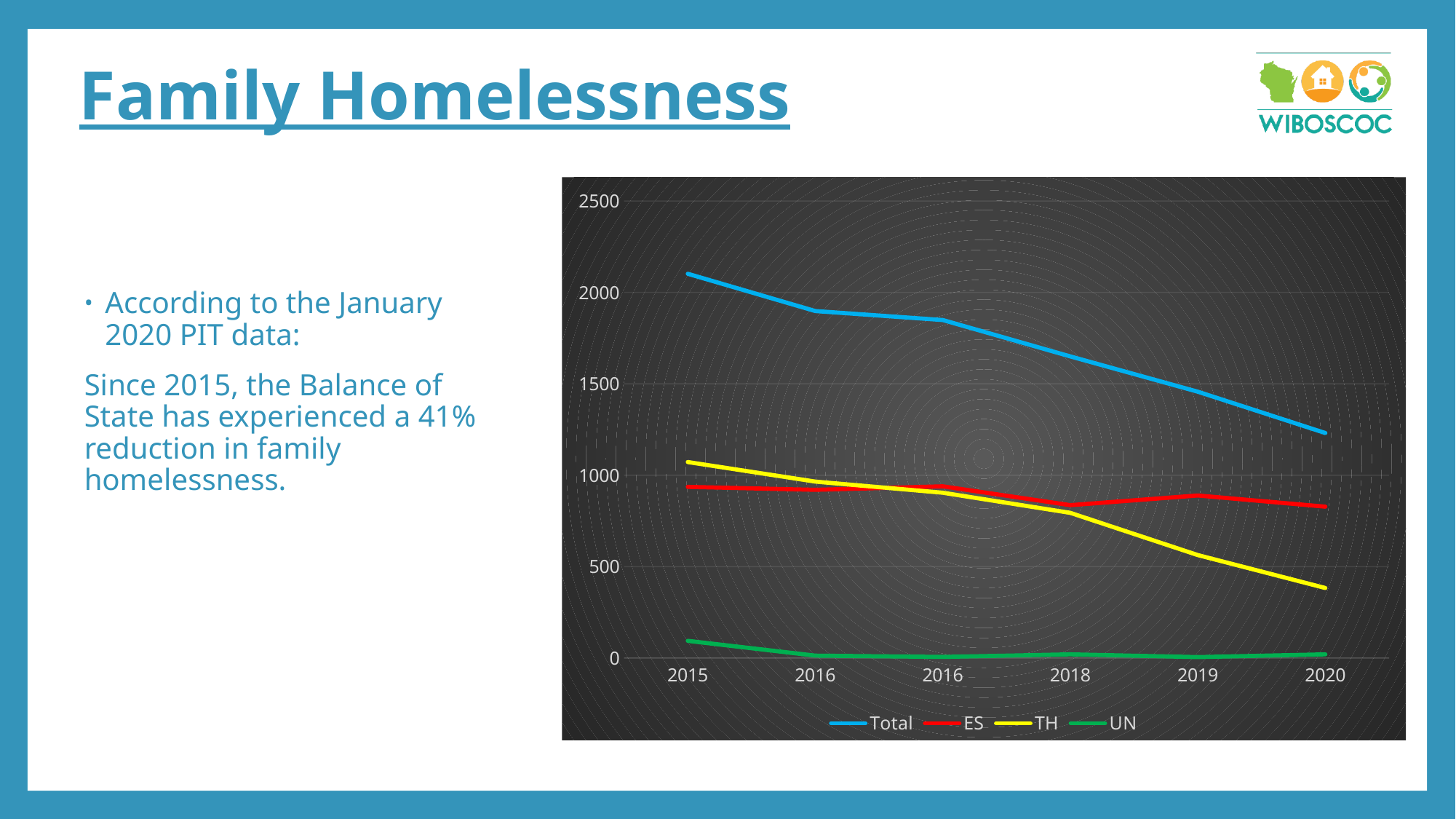
What kind of chart is shown on the slide? line chart Which series has the lowest values across the chart? UN Does the TH series rise or fall from 2015 to 2020? fall In 2020, which series is larger, ES or TH? ES What colour is the line for the UN series? green Is the value for Total in 2020 greater or less than 1500? less Is the value for TH in 2020 greater or less than 500? less Which series has the highest values across the chart? Total Does the Total series rise or fall from 2015 to 2020? fall Is the value for Total in 2015 greater or less than 2000? greater How many points are plotted along the x axis for each series? 6 How many series does the legend list? 4